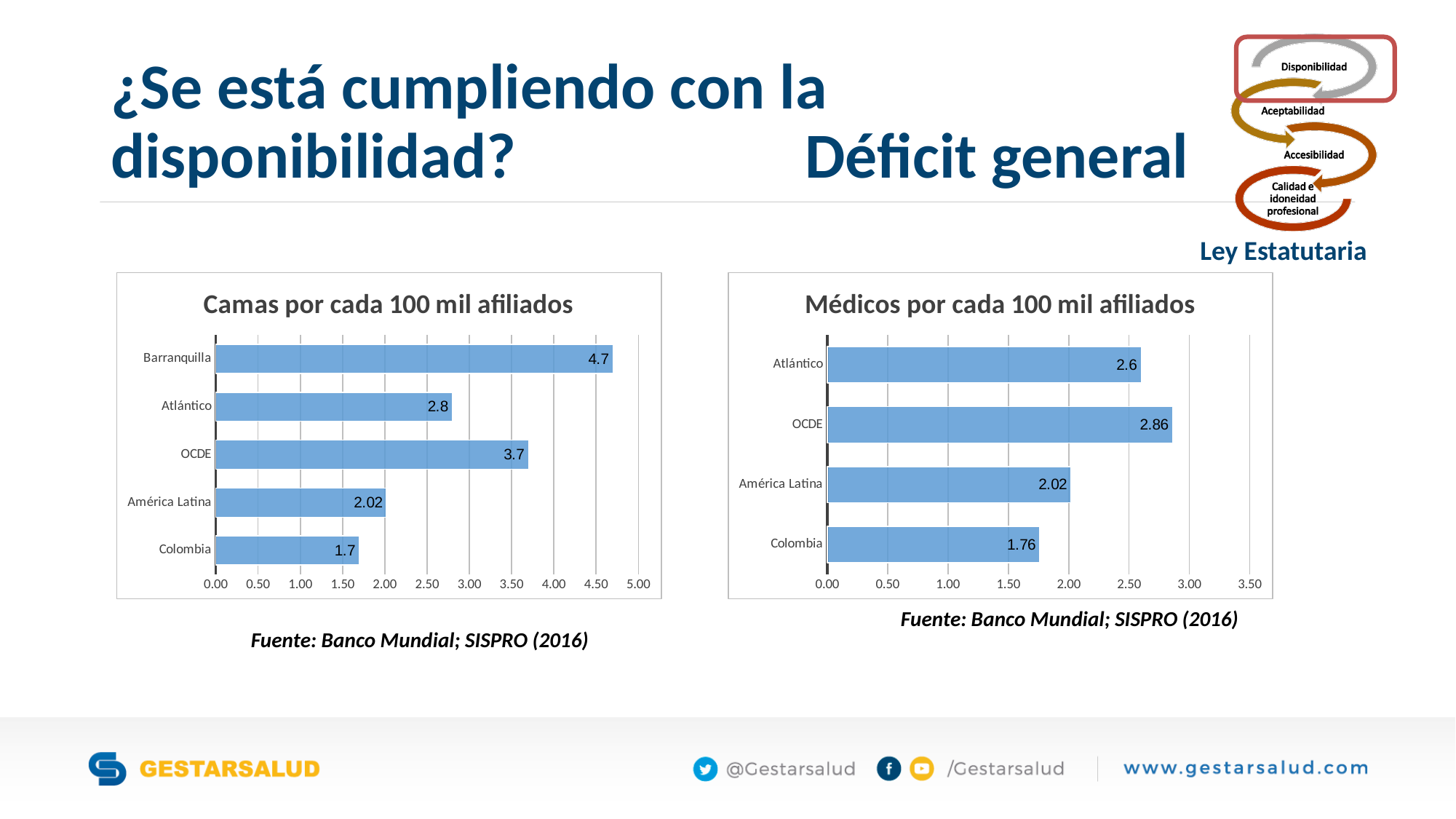
In the 'Médicos por cada 100 mil afiliados' chart, what is the value for Colombia? 1.76 In the 'Camas por cada 100 mil afiliados' chart, what is the difference between the values for OCDE and Colombia? 2.0 In the 'Médicos por cada 100 mil afiliados' chart, what is the difference between the values for Atlántico and Colombia? 0.84 In the 'Médicos por cada 100 mil afiliados' chart, which category has the highest value? OCDE In the 'Médicos por cada 100 mil afiliados' chart, what is the value for OCDE? 2.86 In the 'Camas por cada 100 mil afiliados' chart, which is larger, the value for Atlántico or the value for América Latina? Atlántico What source is cited below the 'Médicos por cada 100 mil afiliados' chart? Banco Mundial; SISPRO (2016) In the 'Camas por cada 100 mil afiliados' chart, which category has the lowest value? Colombia In the 'Camas por cada 100 mil afiliados' chart, what is the value for Barranquilla? 4.7 In the 'Médicos por cada 100 mil afiliados' chart, how many categories are shown? 4 In the 'Camas por cada 100 mil afiliados' chart, how many categories are shown? 5 What kind of chart is the 'Camas por cada 100 mil afiliados' chart? Bar chart